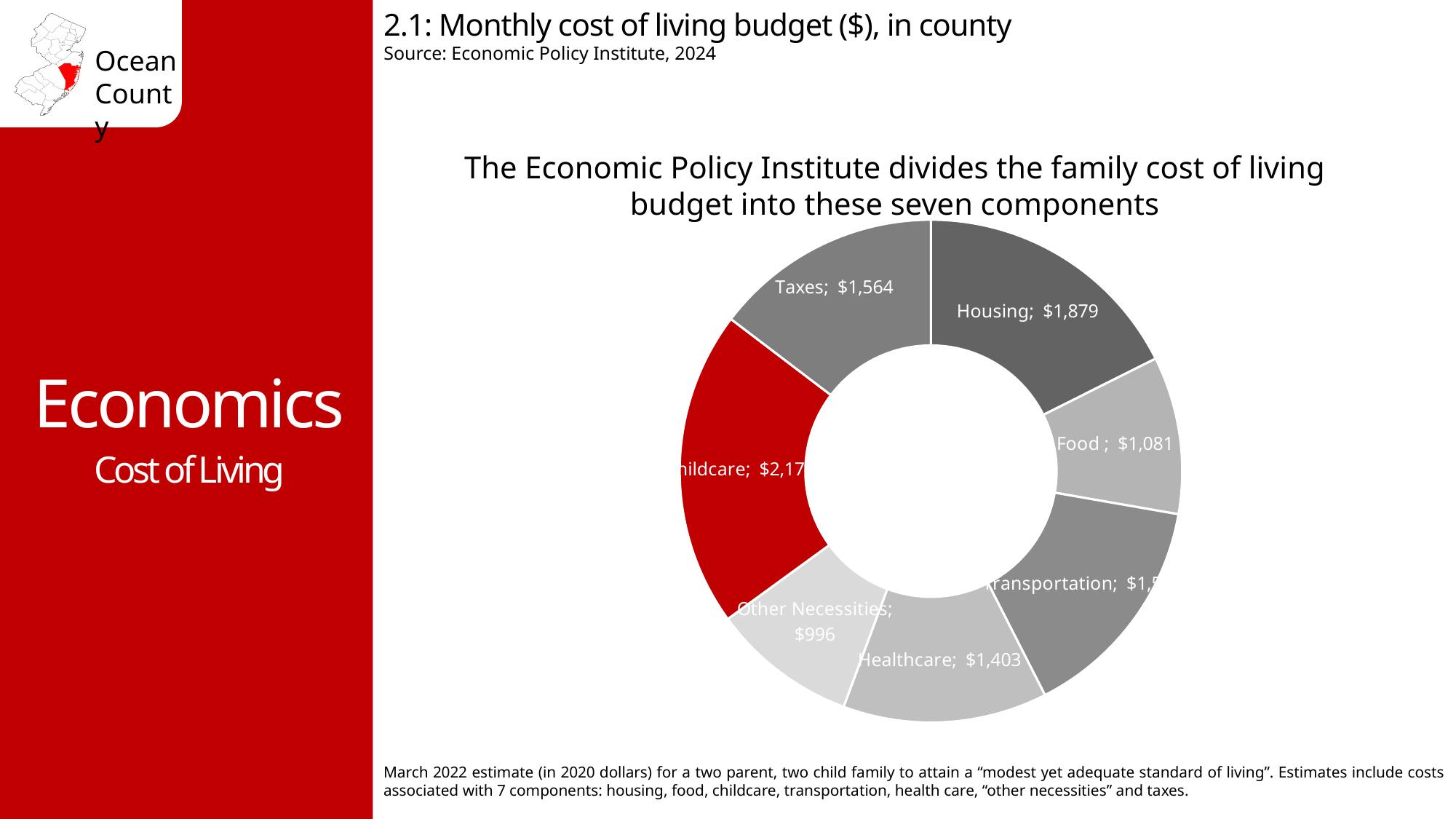
What is the monthly cost for Housing shown on the chart? $1,879 Which is larger, the value for Taxes or the value for Healthcare? Taxes Which component has the smallest monthly cost on the chart? Other Necessities Which component has the largest slice of the chart? Childcare What colour is the Childcare slice on the chart? Red How many components are shown on the chart? 7 What is the difference between the Healthcare and Other Necessities values? $407 What is the monthly cost for Food shown on the chart? $1,081 What is the monthly cost for Taxes shown on the chart? $1,564 What is the monthly cost for Other Necessities shown on the chart? $996 What is the monthly cost for Healthcare shown on the chart? $1,403 What is the difference between the Housing and Taxes values? $315